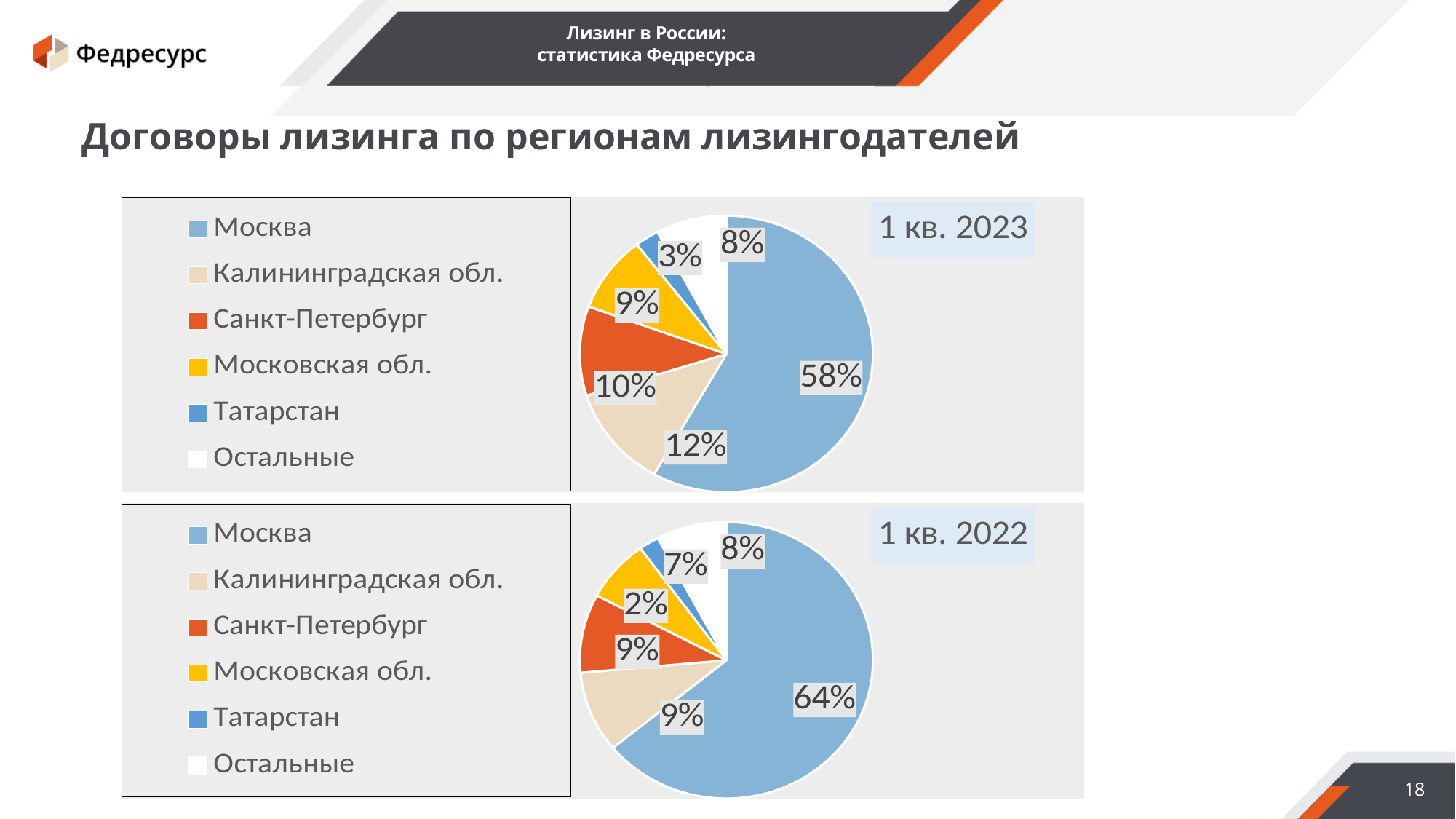
What type of chart is used on this slide? Pie chart In the 1 кв. 2023 pie chart, what share does Калининградская обл. have? 12% In the 1 кв. 2023 pie chart, what share does Москва have? 58% In the 1 кв. 2022 pie chart, what share does Калининградская обл. have? 9% In the 1 кв. 2022 pie chart, what share does Москва have? 64% In the 1 кв. 2023 pie chart, what share does Санкт-Петербург have? 10% In the 1 кв. 2023 pie chart, which region has the largest share? Москва How many slices does the 1 кв. 2023 pie chart have? 6 In the 1 кв. 2023 pie chart, which region has the smallest share? Татарстан What is the title of the slide? Договоры лизинга по регионам лизингодателей In the 1 кв. 2023 pie chart, which is larger: the share of Калининградская обл. or the share of Московская обл.? Калининградская обл. By how many percentage points did the share of Москва change from 1 кв. 2022 to 1 кв. 2023? 6 percentage points (64% to 58%)